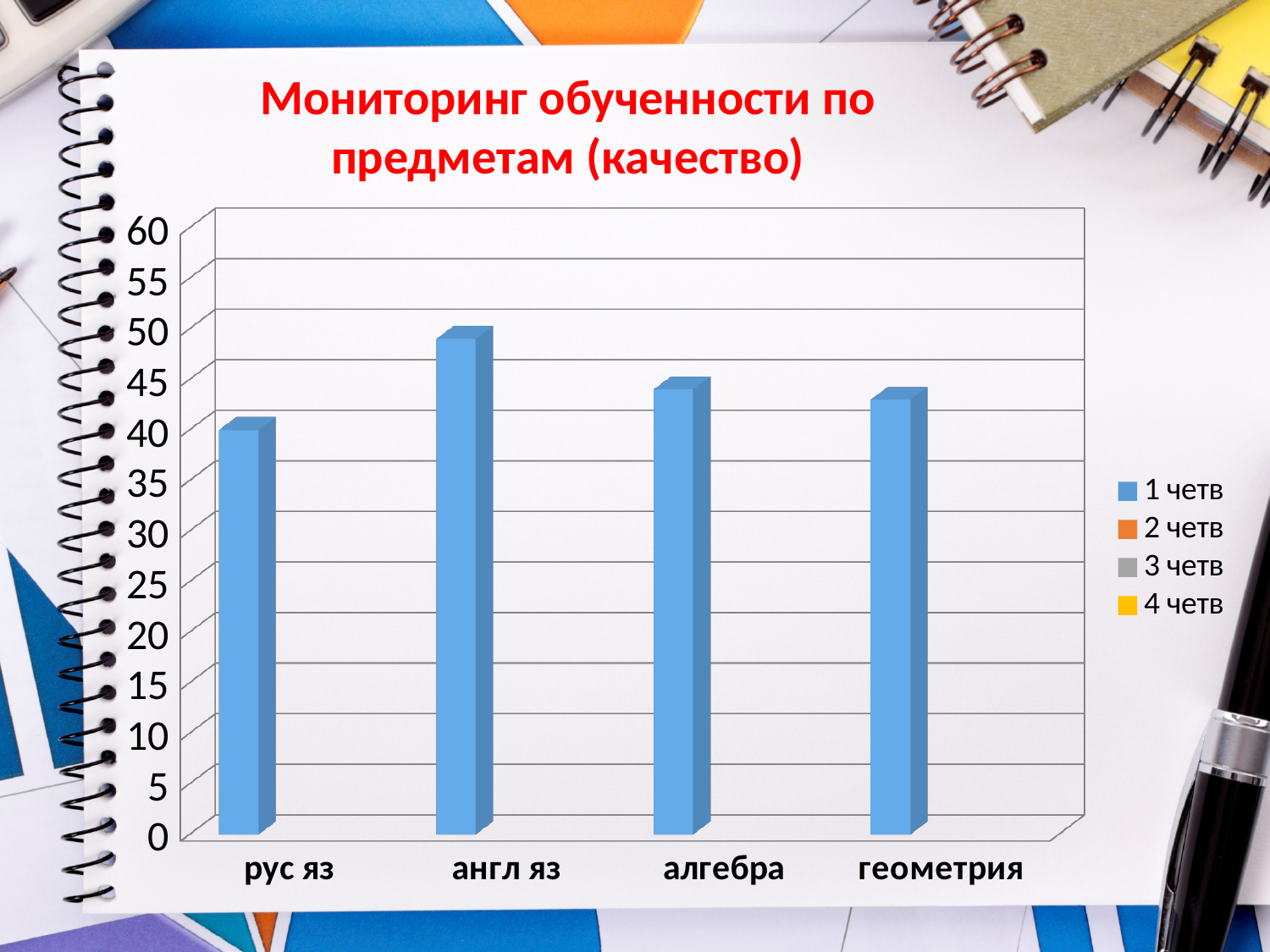
Is the value for англ яз greater or less than 45? greater Which subject has the lowest bar? рус яз Which has a higher value, англ яз or геометрия? англ яз Is the value for алгебра greater or less than 40? greater Is the value for рус яз greater or less than 45? less How many series does the legend list? 4 What is the title of the chart? Мониторинг обученности по предметам (качество) Which subject has the highest bar? англ яз What kind of chart is shown on the slide? bar chart How many subject categories are shown on the x axis? 4 Which has a higher value, англ яз or рус яз? англ яз